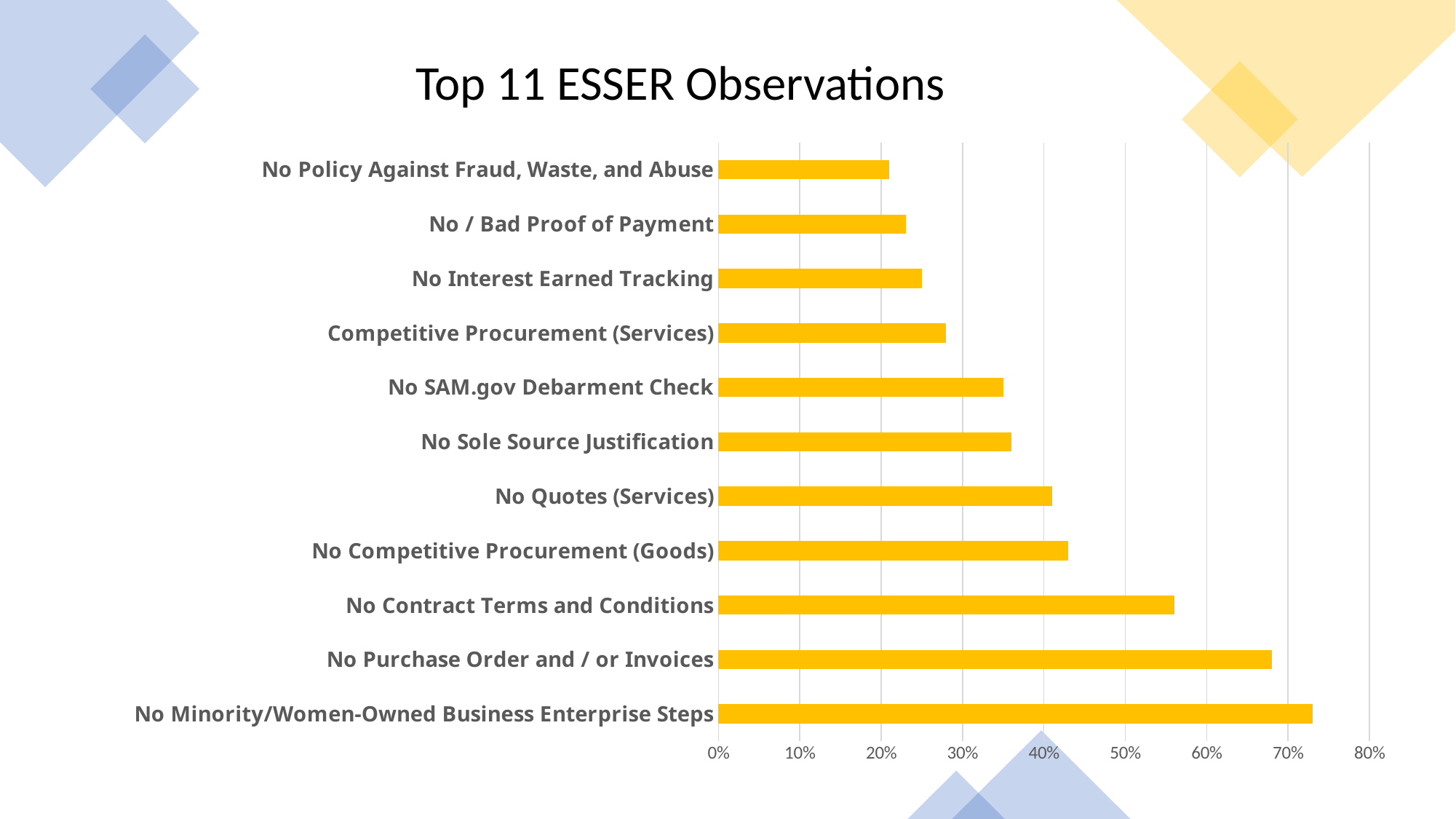
Which has a larger value: No Contract Terms and Conditions or No Quotes (Services)? No Contract Terms and Conditions What colour are the bars in the chart? Yellow Is the value for Competitive Procurement (Services) greater or less than 30%? less Is the value for No Purchase Order and / or Invoices greater or less than 70%? less Which observation has the lowest value? No Policy Against Fraud, Waste, and Abuse Which observation has the highest value? No Minority/Women-Owned Business Enterprise Steps How many categories (observations) are plotted in the chart? 11 What type of chart is shown on the slide? Bar chart Is the value for No Minority/Women-Owned Business Enterprise Steps greater or less than 70%? greater What is the title of the chart? Top 11 ESSER Observations